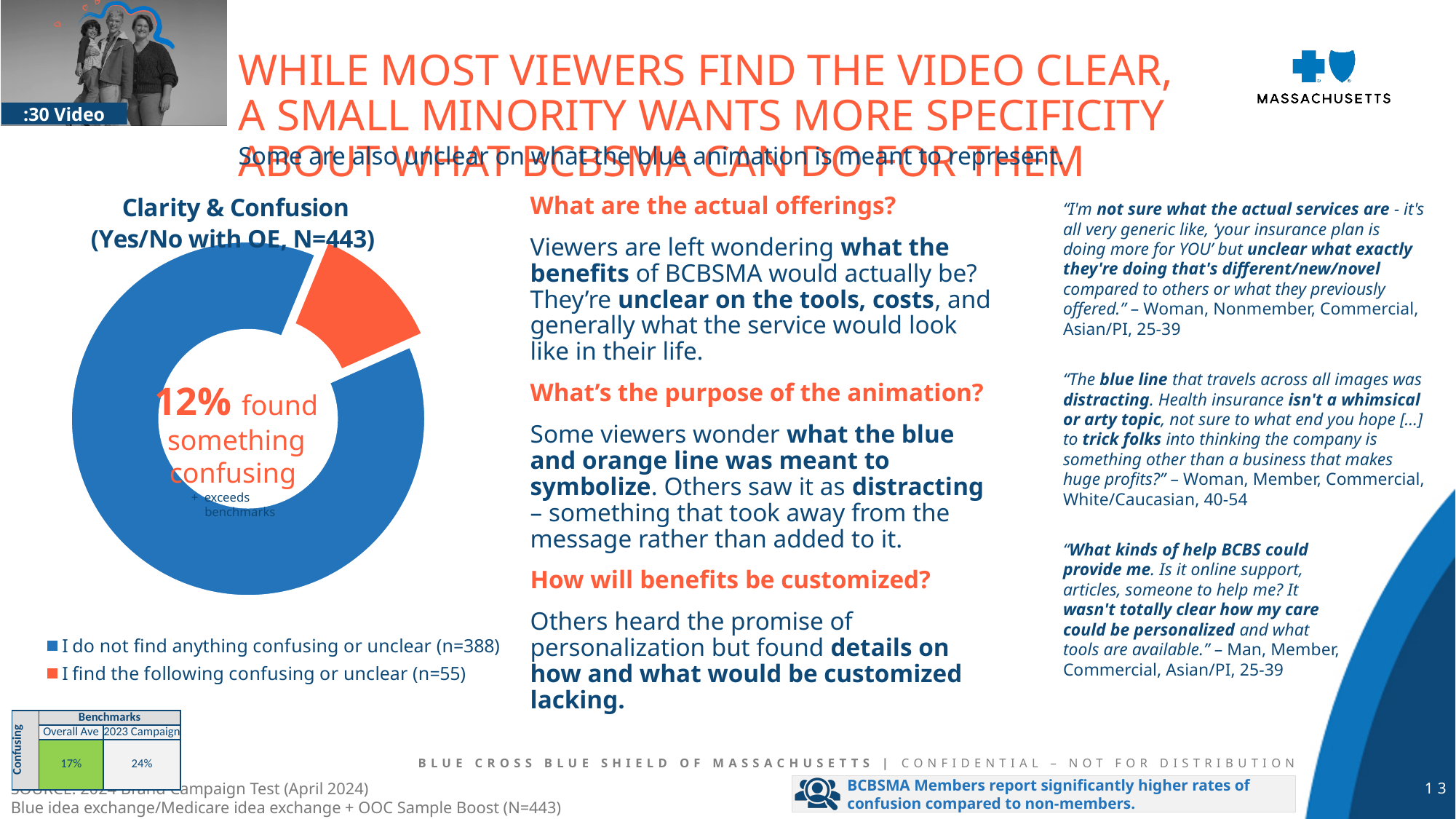
What is the full title of the donut chart on the slide? Clarity & Confusion (Yes/No with OE, N=443) What percentage of viewers found something confusing, according to the label in the centre of the donut chart? 12% In the Benchmarks table below the chart, what is the Overall Ave value for Confusing? 17% What kind of chart is shown under the title "Clarity & Confusion"? Pie chart (donut) What is the n for "I find the following confusing or unclear" in the Clarity & Confusion chart? n=55 What colour is the slice for "I find the following confusing or unclear" in the Clarity & Confusion chart? Orange How many categories does the legend of the Clarity & Confusion chart list? 2 What is the total N shown in the title of the Clarity & Confusion chart? N=443 What is the difference in respondents between the two categories of the Clarity & Confusion chart (388 minus 55)? 333 Which category is larger in the Clarity & Confusion chart: "I do not find anything confusing or unclear" or "I find the following confusing or unclear"? I do not find anything confusing or unclear Which category has the smallest slice in the Clarity & Confusion chart? I find the following confusing or unclear (n=55) What is the n for "I do not find anything confusing or unclear" in the Clarity & Confusion chart? n=388